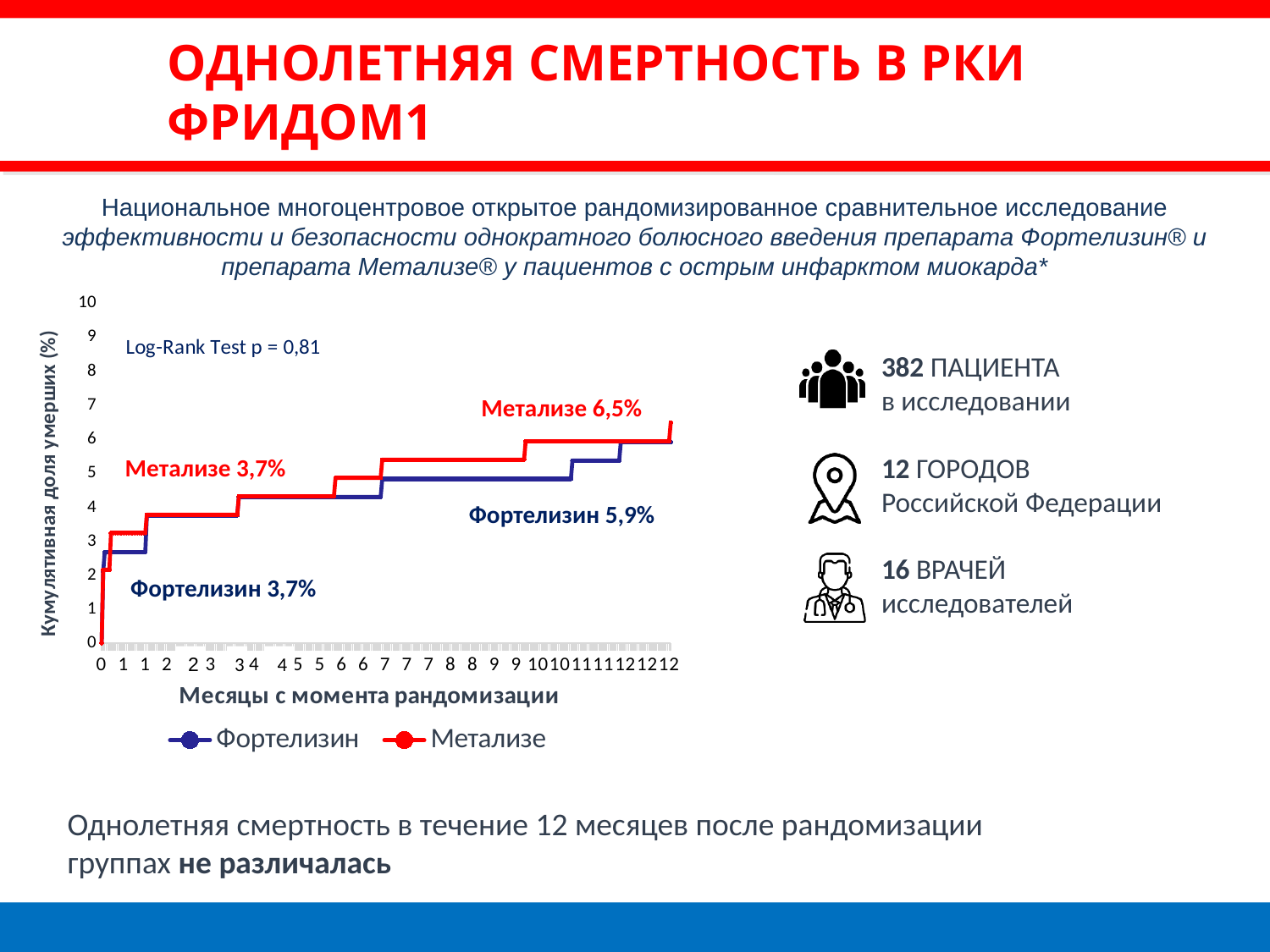
What Log-Rank Test p value is printed on the chart? p = 0,81 Do the cumulative mortality curves rise or fall as months since randomization increase? rise What type of chart is shown on the slide? line chart Which series has the higher final labelled value, Метализе or Фортелизин? Метализе What is the earlier labelled value shown for Фортелизин on the chart? 3,7% What is the difference between the final labelled values for Метализе (6,5%) and Фортелизин (5,9%)? 0,6% Is the final value for Фортелизин greater or less than 7 on the y axis? less What is the highest tick value shown on the y axis of the chart? 10 How many series does the chart legend list? 2 What is the final labelled cumulative mortality value for Метализе? 6,5% What are the two series named in the chart legend? Фортелизин and Метализе What is the final labelled cumulative mortality value for Фортелизин? 5,9%